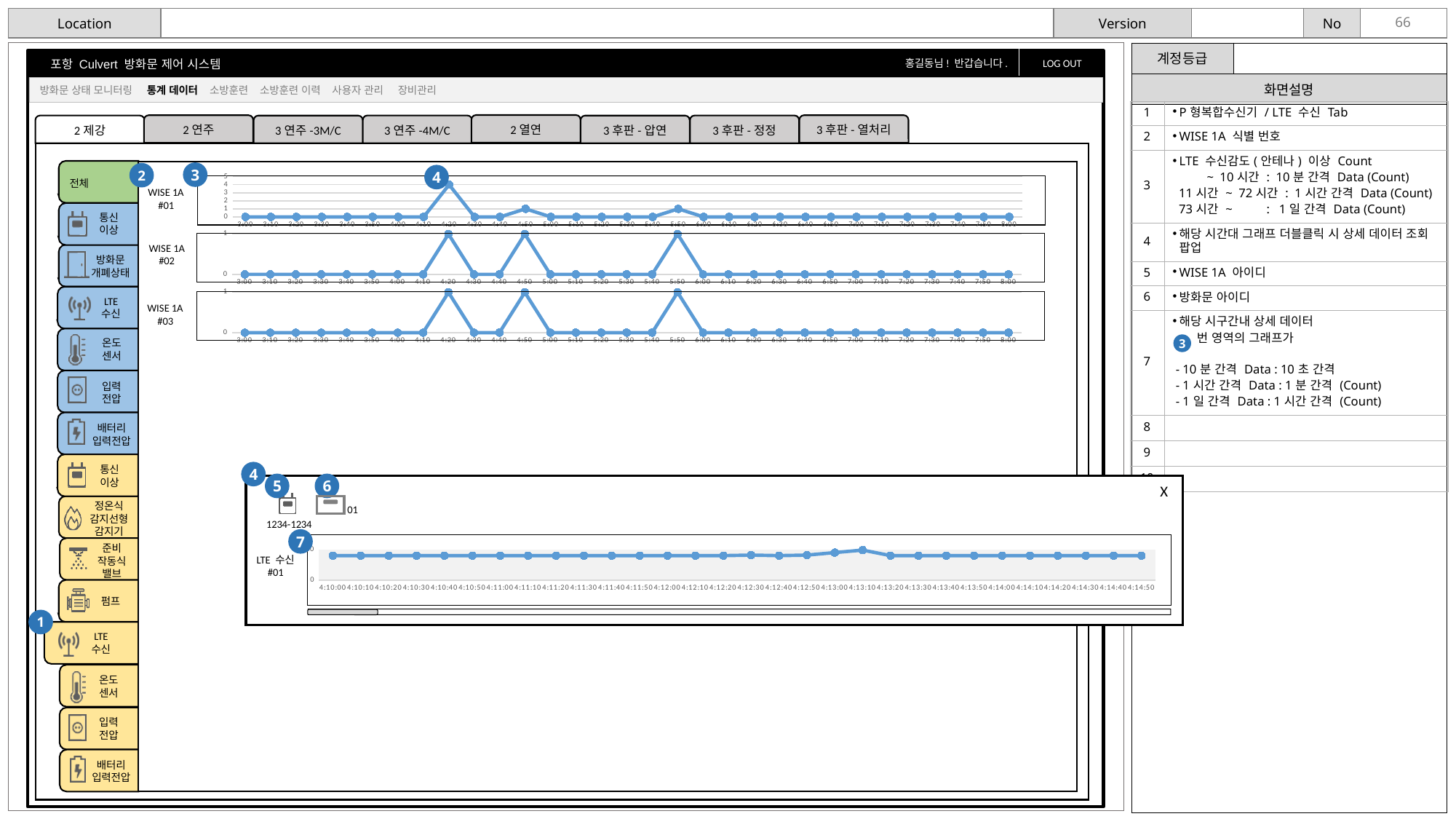
What kind of chart is the WISE 1A #02 chart? line chart How many WISE 1A charts are shown in the main statistics area? 3 In the WISE 1A #02 chart, how many times does the line reach the value 1? 3 In the WISE 1A #01 chart, is the value at 4:20 greater or less than 3? greater In the WISE 1A #03 chart, what is the value at 5:50? 1 In the WISE 1A #02 chart, what is the difference between the value at 4:50 and the value at 5:00? 1 What is the series label of the chart in the popup window at the bottom of the slide? LTE 수신 #01 In the WISE 1A #01 chart, is the value at 3:00 greater or less than 1? less In the WISE 1A #02 chart, which is larger, the value at 4:20 or the value at 4:30? 4:20 In the WISE 1A #03 chart, what is the value at 6:00? 0 In the WISE 1A #02 chart, what is the value at 4:20? 1 In the WISE 1A #02 chart, what is the value at 3:00? 0